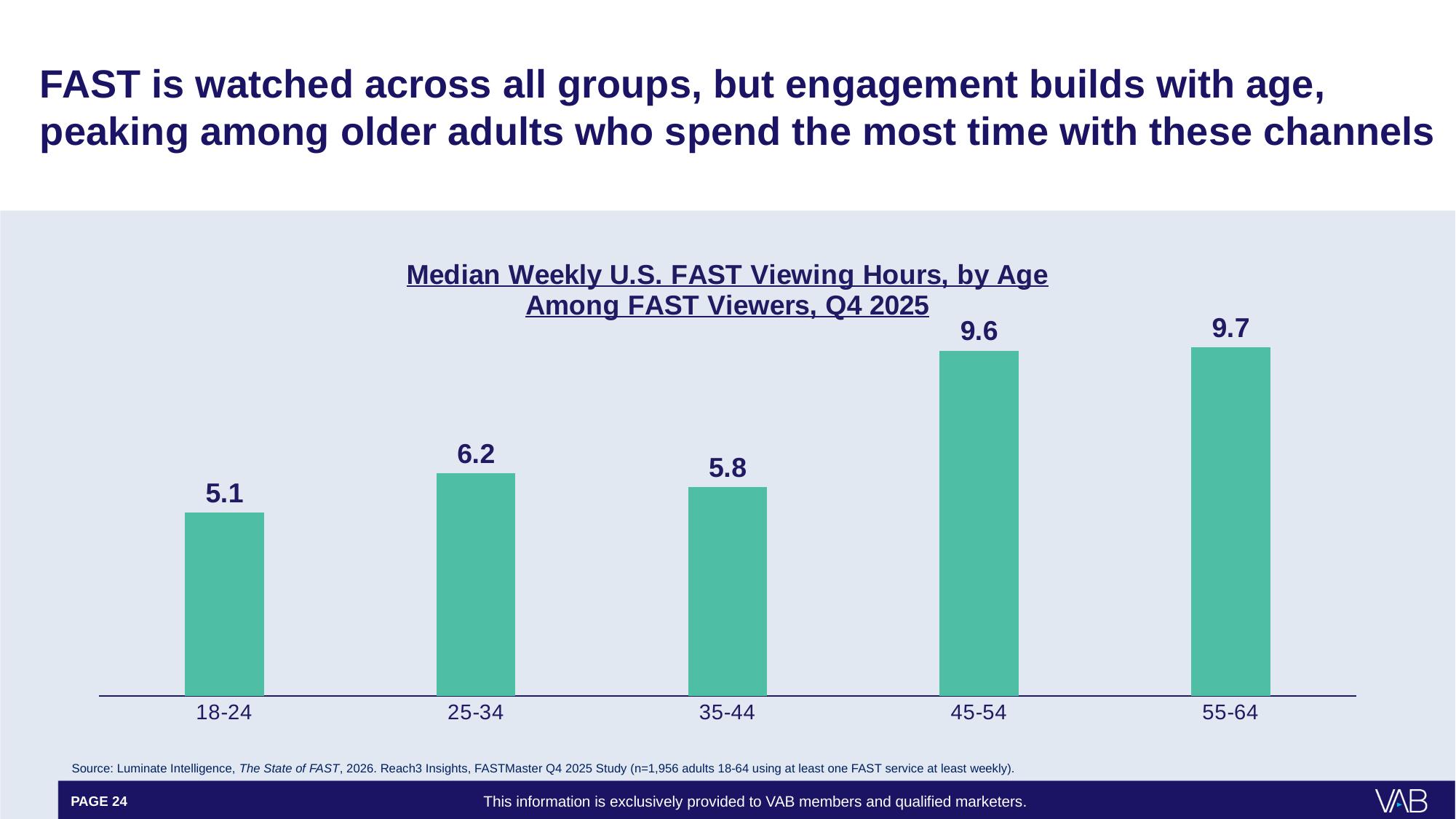
Do median weekly FAST viewing hours generally rise or fall as age increases across the chart? Rise What type of chart is shown on the slide? Bar chart What is the difference in median weekly FAST viewing hours between the 25-34 and 35-44 age groups? 0.4 Which age group has the lowest median weekly FAST viewing hours? 18-24 What is the median weekly FAST viewing hours for the 45-54 age group? 9.6 What is the median weekly FAST viewing hours for the 18-24 age group? 5.1 Which age group has the highest median weekly FAST viewing hours? 55-64 What is the median weekly FAST viewing hours for the 35-44 age group? 5.8 What is the title of the chart? Median Weekly U.S. FAST Viewing Hours, by Age Among FAST Viewers, Q4 2025 What is the difference in median weekly FAST viewing hours between the 55-64 and 18-24 age groups? 4.6 Which age group has higher median weekly FAST viewing hours, 25-34 or 35-44? 25-34 How many age groups are shown in the chart? 5